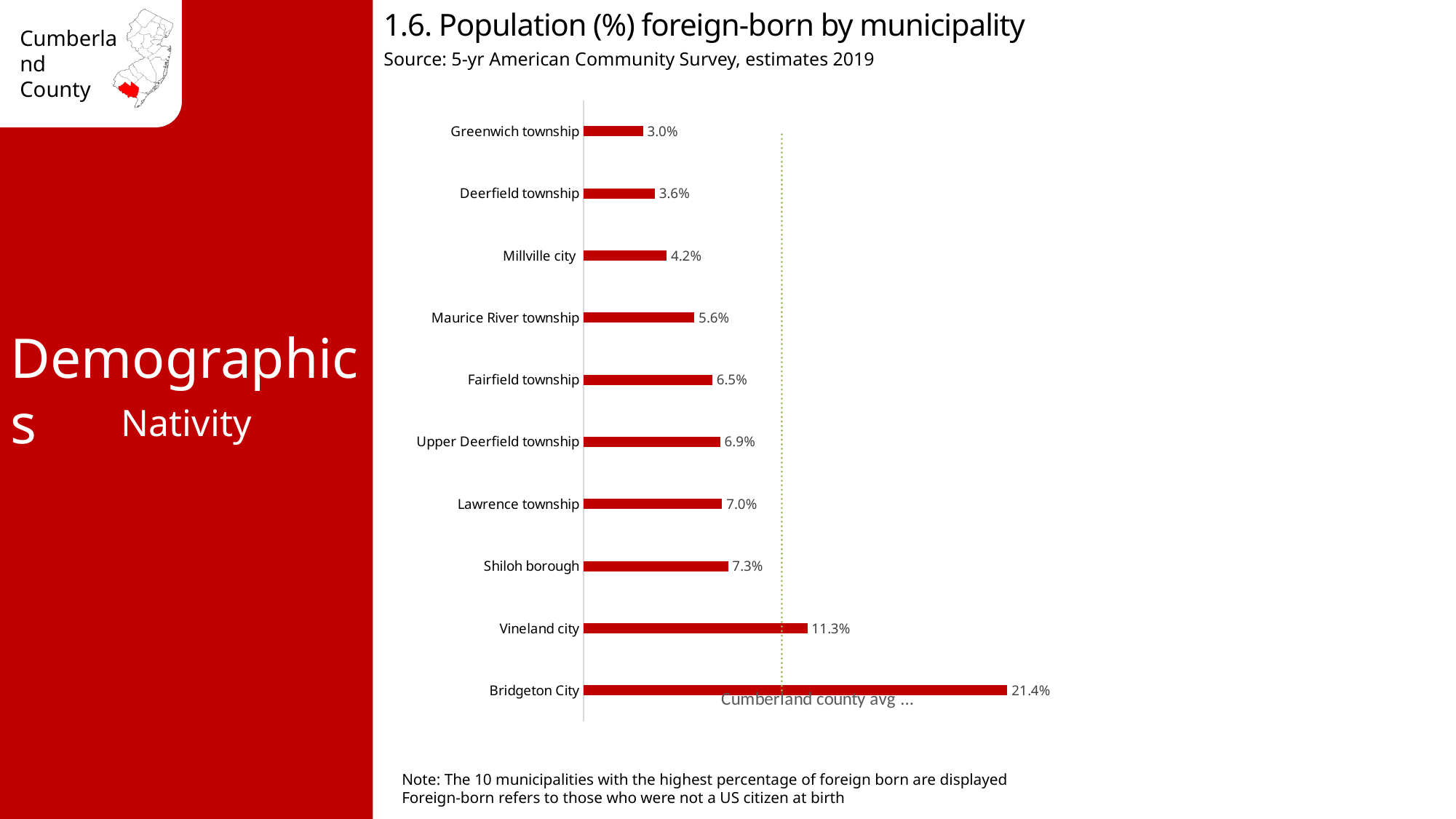
Which municipality has the highest percentage of foreign-born population? Bridgeton City What is the foreign-born percentage shown for Vineland city? 11.3% What value is shown for Maurice River township? 5.6% What percentage of the population is foreign-born in Bridgeton City? 21.4% What is the source of the data shown in the chart? 5-yr American Community Survey, estimates 2019 What type of chart is used on this slide? Bar chart How many municipalities are shown in the chart? 10 What does the dotted vertical line in the chart represent? Cumberland county avg What is the difference between the values for Shiloh borough and Greenwich township? 4.3% What is the difference between the foreign-born percentages of Bridgeton City and Vineland city? 10.1% Which has a higher foreign-born percentage, Millville city or Fairfield township? Fairfield township Which municipality has the lowest percentage of foreign-born population? Greenwich township